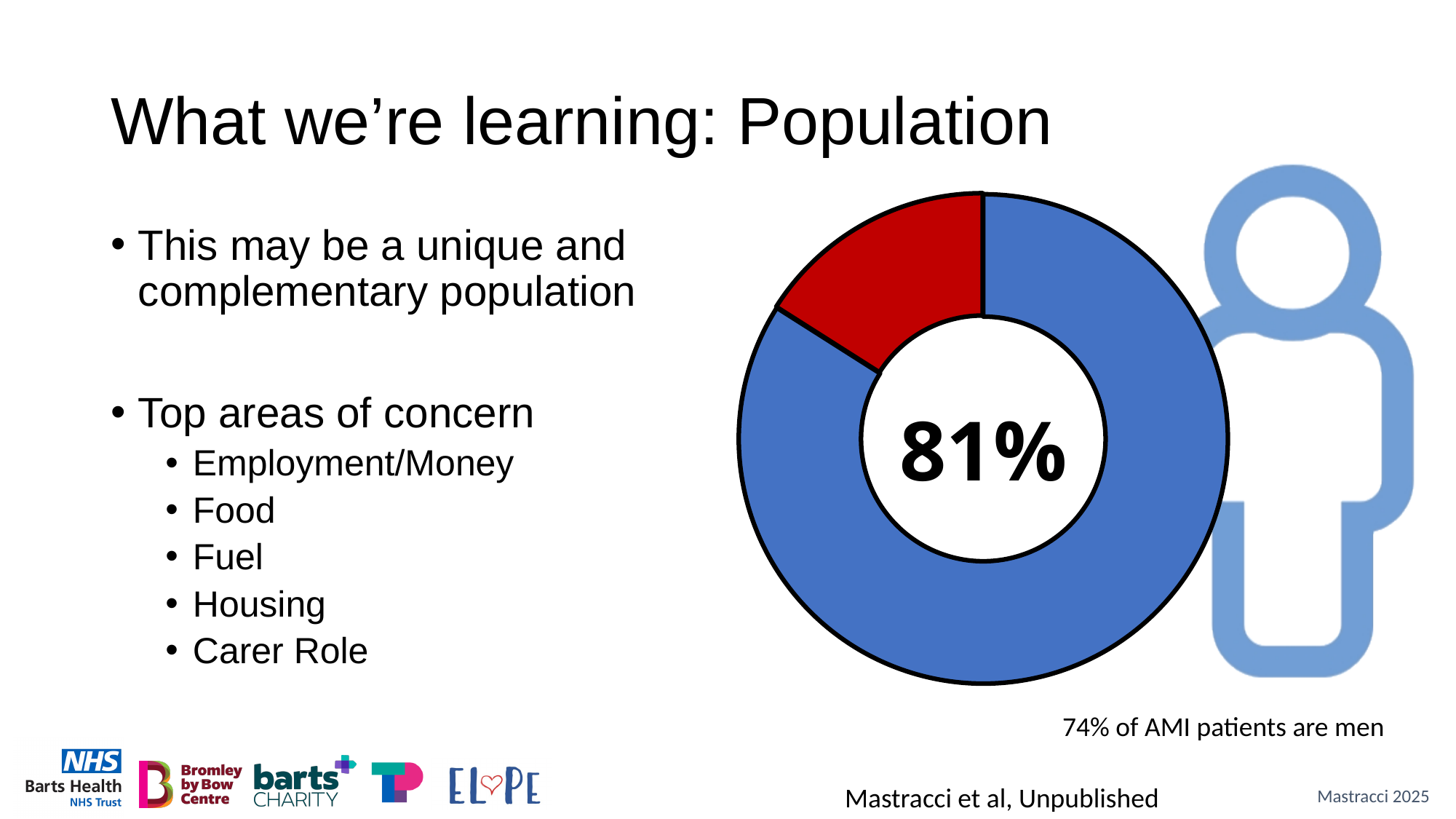
Which slice of the donut chart is larger, the blue one or the red one? blue Does the donut chart have a legend? No What kind of chart is shown on the slide? pie chart (donut) Is the blue slice's share of the donut chart greater or less than 50%? greater What two colours are used for the slices of the donut chart? blue and red What percentage is printed in the centre of the donut chart? 81% Is the red slice's share of the donut chart greater or less than 50%? less How many slices does the donut chart have? 2 Which colour slice is the largest in the donut chart? blue Which colour slice is the smallest in the donut chart? red